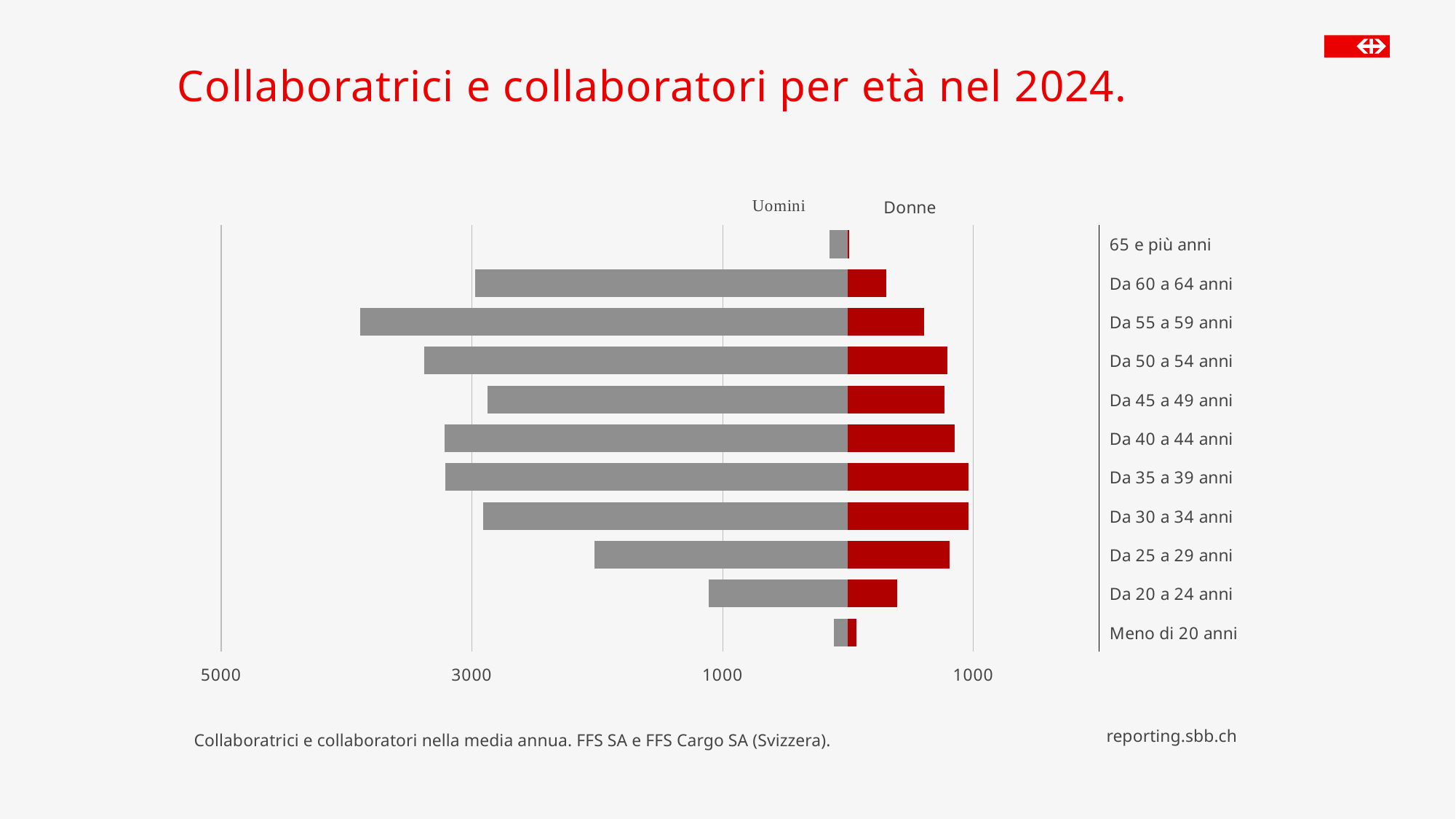
What colour are the Donne bars? red How many series does the chart show? 2 Is the Uomini value for Da 60 a 64 anni greater or less than 1000? greater Is the Donne value for Da 60 a 64 anni greater or less than 1000? less Is the Uomini value for Da 55 a 59 anni greater or less than 3000? greater How many age categories are shown in the chart? 11 Which is larger for Uomini: Da 55 a 59 anni or Da 50 a 54 anni? Da 55 a 59 anni Which age category has the highest value for Uomini? Da 55 a 59 anni What kind of chart is shown on the slide? bar chart Which is larger for Donne: Da 50 a 54 anni or Da 60 a 64 anni? Da 50 a 54 anni What is the title of the chart? Collaboratrici e collaboratori per età nel 2024.